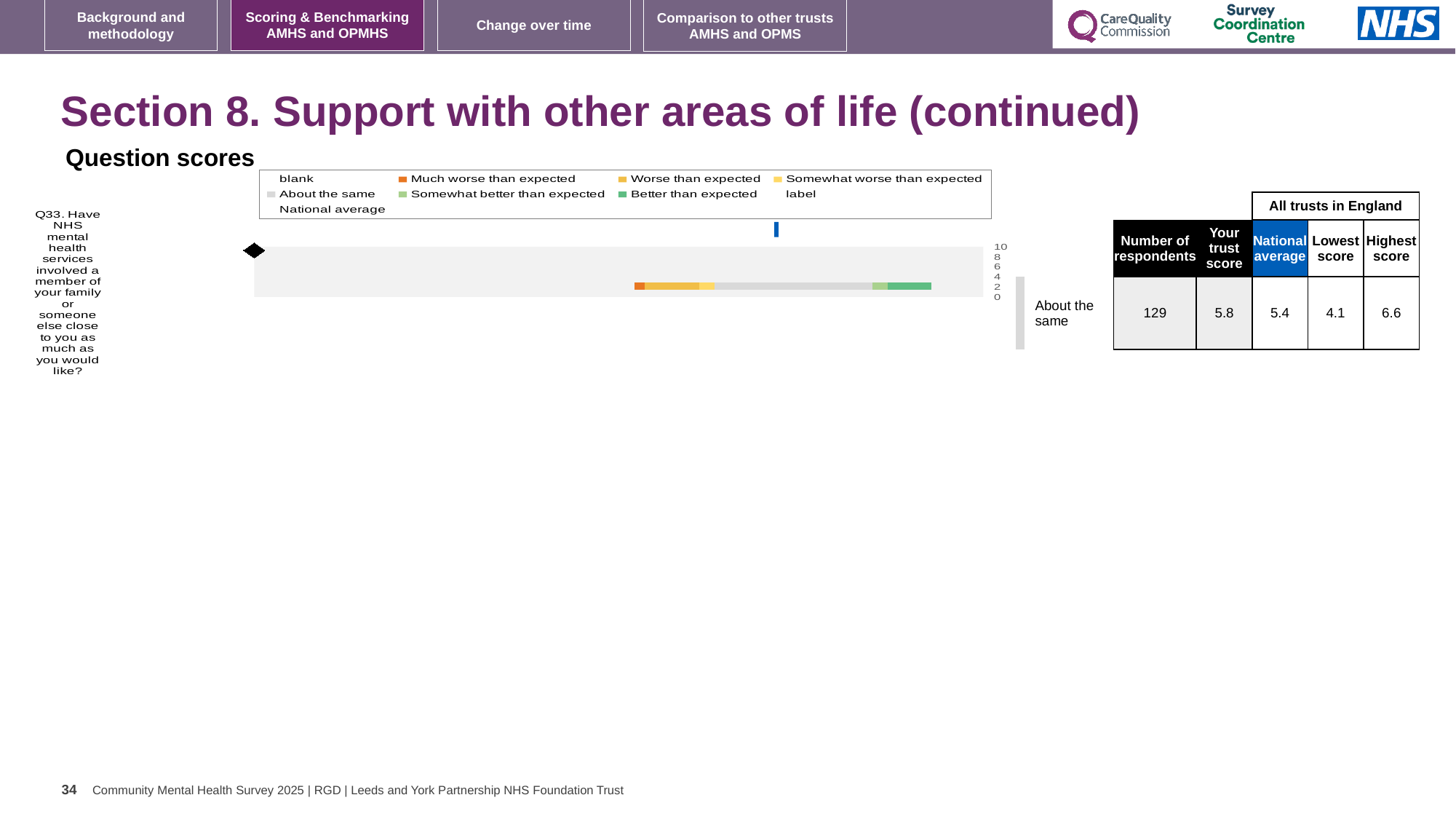
In the table next to the chart, what is the highest score among all trusts in England for Q33? 6.6 In the table next to the chart, what is the difference between the highest score and the lowest score for Q33? 2.5 In the table next to the chart, what is the lowest score among all trusts in England for Q33? 4.1 In the table next to the chart, what is the number of respondents for Q33? 129 How many survey questions are plotted in the chart? 1 What kind of chart is shown under 'Question scores'? bar chart In the table next to the chart, what is the national average for Q33? 5.4 Which legend entry is shown in orange? Much worse than expected In the table next to the chart, which is larger for Q33: your trust score or the national average? Your trust score In the table next to the chart, what is 'Your trust score' for Q33? 5.8 Which benchmark category label is shown to the right of the bar for Q33? About the same How many entries does the chart legend list? 9